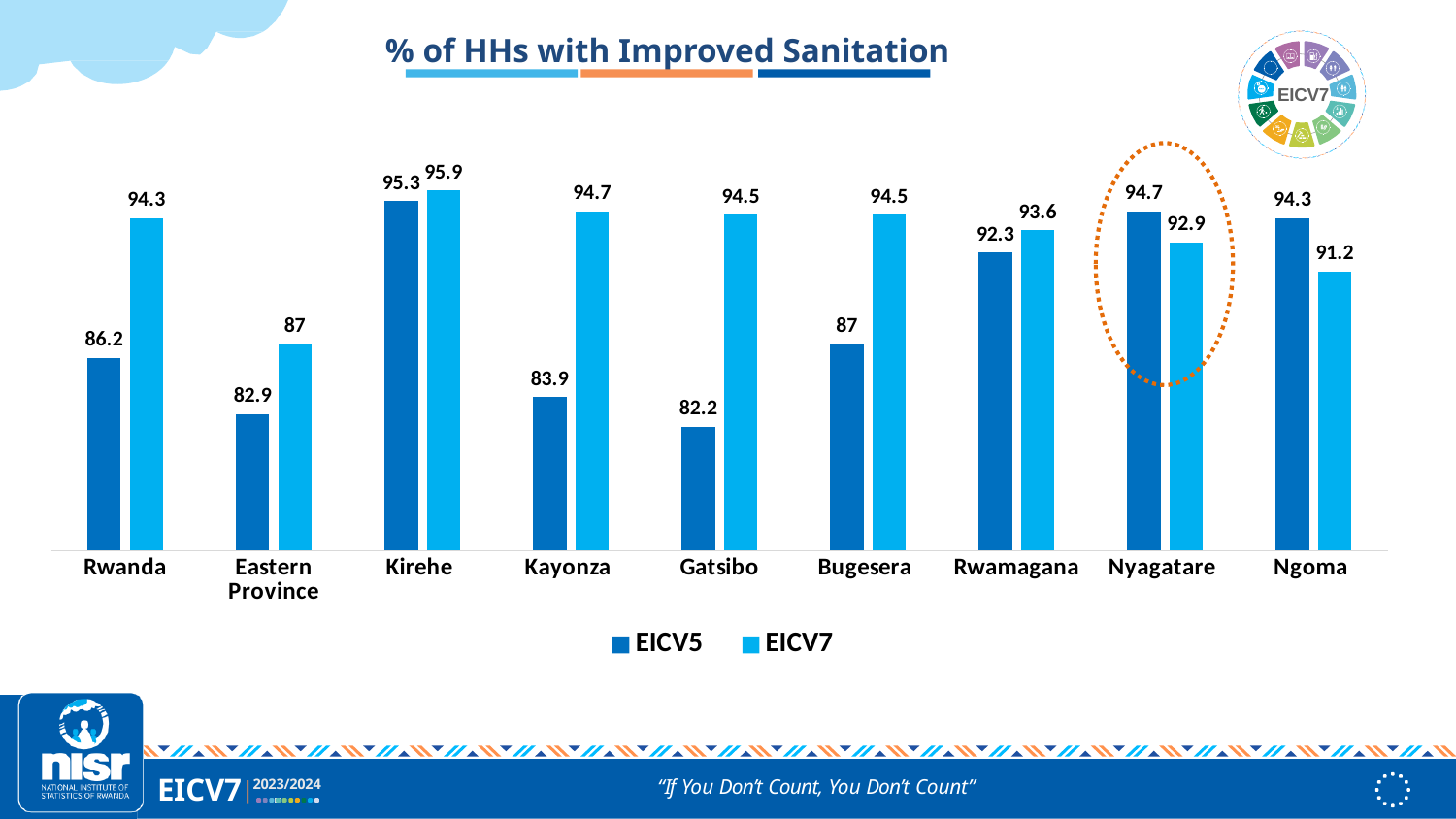
What is the difference between the EICV7 and EICV5 values for Kayonza? 10.8 What is the EICV5 value for Gatsibo? 82.2 What is the EICV7 value for Eastern Province? 87 What kind of chart is shown on the slide? Bar chart How many series does the legend list? 2 What is the EICV7 value for Kayonza? 94.7 Which category has the highest EICV7 value? Kirehe For Nyagatare, which is larger: the EICV5 value or the EICV7 value? EICV5 How many categories are shown on the x axis? 9 What is the difference between the EICV7 and EICV5 values for Rwanda? 8.1 Which category has the lowest EICV5 value? Gatsibo What is the title of the chart? % of HHs with Improved Sanitation